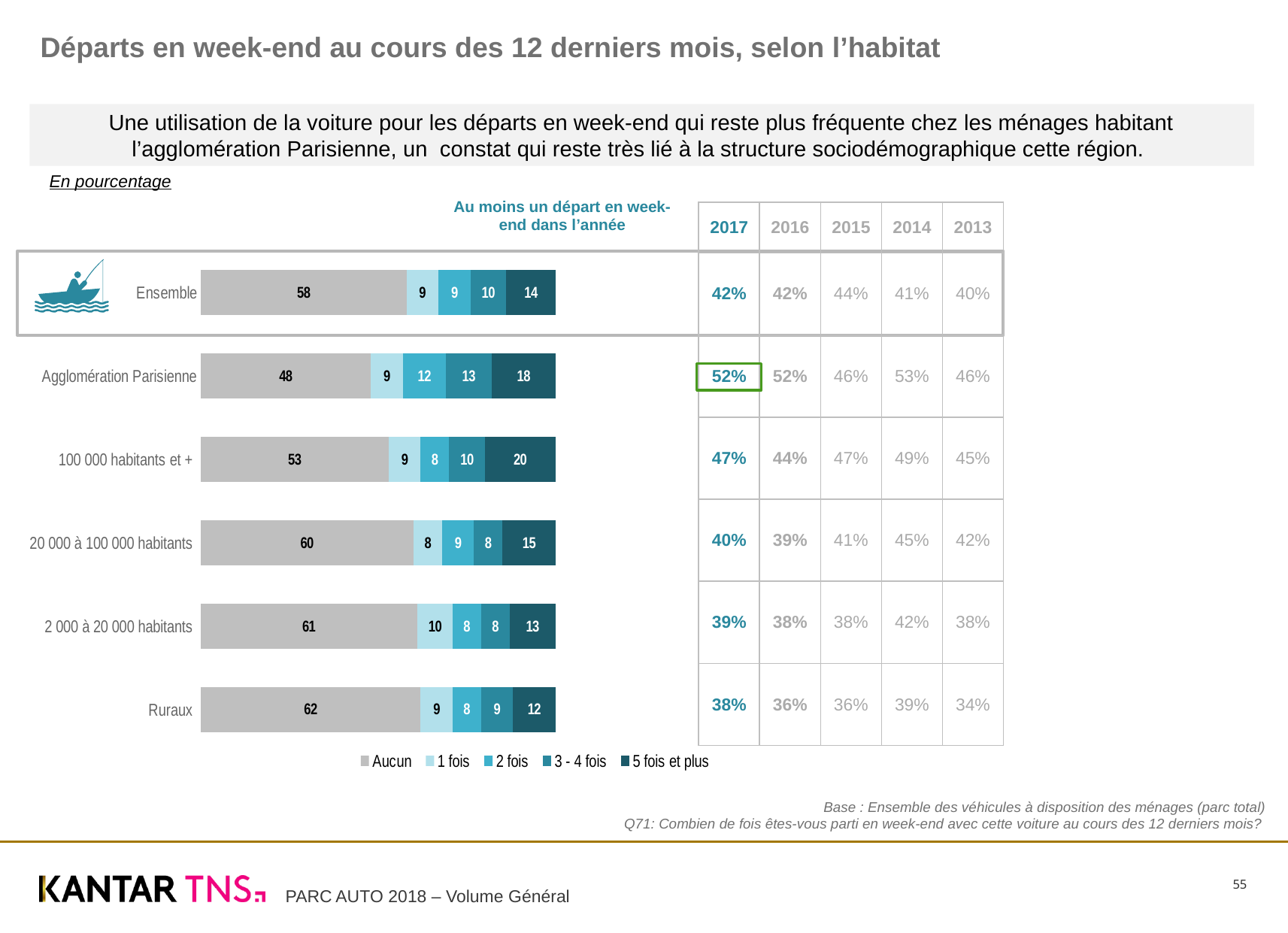
Which category has the lowest value for "Aucun"? Agglomération Parisienne Which is larger: the "5 fois et plus" value for Agglomération Parisienne or for Ruraux? Agglomération Parisienne What is the value of "Aucun" for Agglomération Parisienne? 48 What is the total of the stacked bar for Ensemble? 100 Which legend entry is shown in grey? Aucun What is the value of "5 fois et plus" for 100 000 habitants et +? 20 What is the difference between the "Aucun" values for Ruraux and Agglomération Parisienne? 14 How many categories are shown in the bar chart? 6 Which category has the highest value for "Aucun"? Ruraux What kind of chart is shown on the slide? Stacked bar chart How many series does the legend list? 5 What is the value of "1 fois" for 2 000 à 20 000 habitants? 10